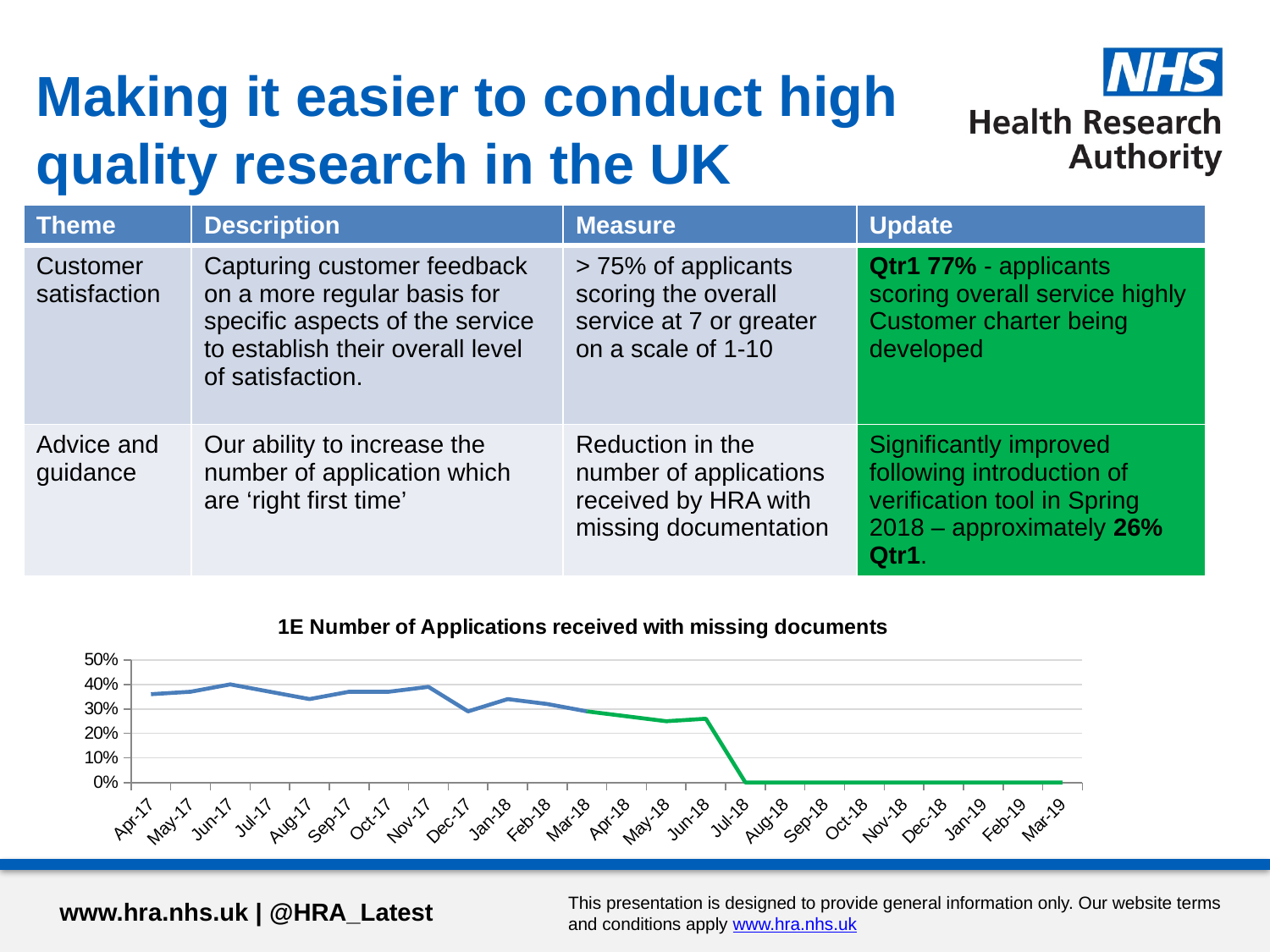
Is the value for Jan-19 greater or less than 10%? less What kind of chart is shown on the slide? line chart Which is larger, the value for Jan-18 or the value for Jun-18? Jan-18 How many months are plotted along the x axis of the chart? 24 Is the value for Jul-18 greater or less than 10%? less What is the title of the chart on the slide? 1E Number of Applications received with missing documents Overall, do the values rise or fall from Apr-17 to Mar-19? fall Is the value for Dec-17 greater or less than 40%? less Which is larger, the value for Apr-17 or the value for Dec-17? Apr-17